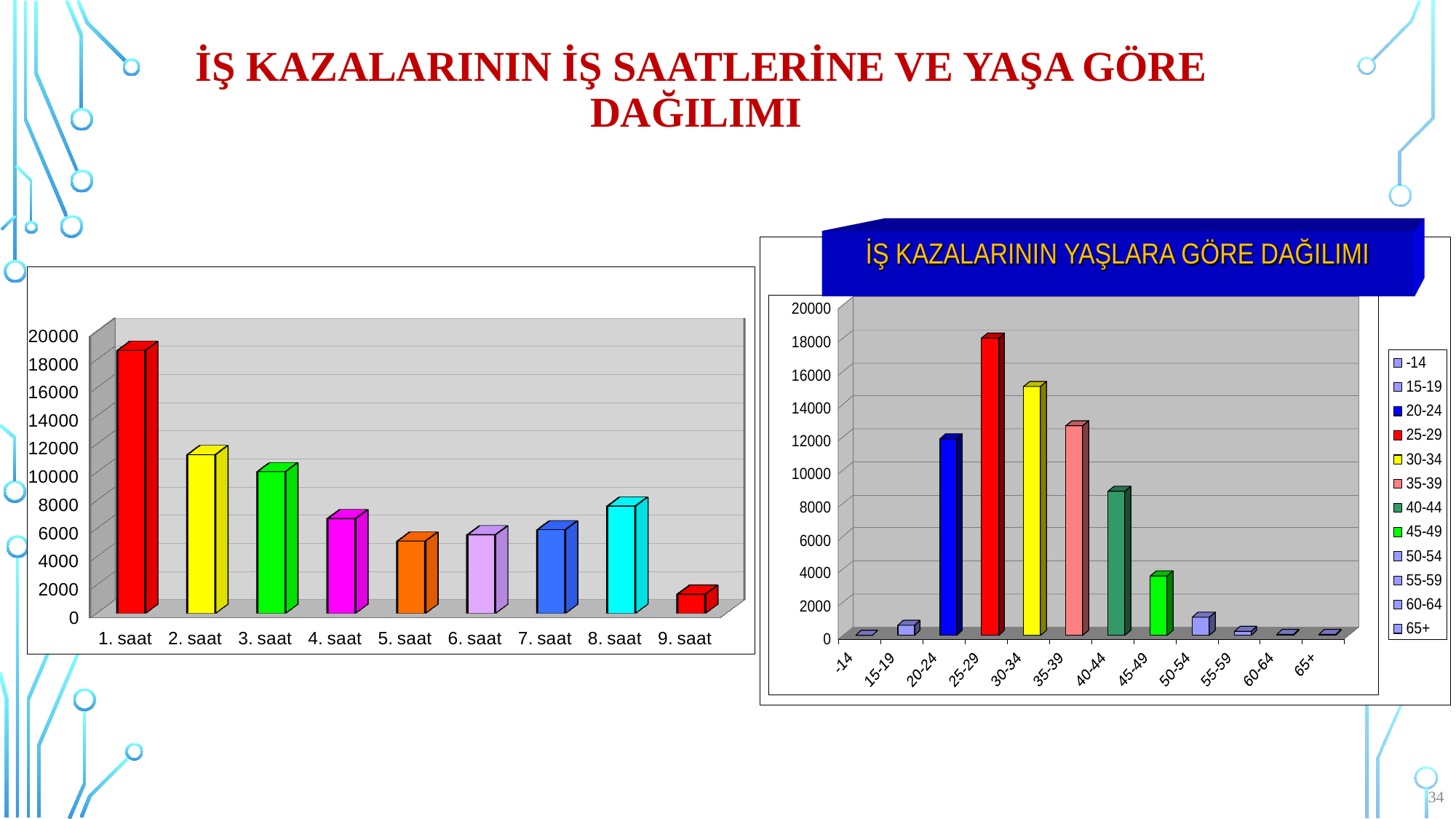
On the left chart, how many hour categories are shown on the x axis? 9 On the chart titled 'İŞ KAZALARININ YAŞLARA GÖRE DAĞILIMI', which age group has the highest number of accidents? 25-29 On the chart titled 'İŞ KAZALARININ YAŞLARA GÖRE DAĞILIMI', which is larger, the value for 20-24 or the value for 40-44? 20-24 On the left chart, which hour has the lowest number of accidents? 9. saat What kind of chart is the chart titled 'İŞ KAZALARININ YAŞLARA GÖRE DAĞILIMI'? bar chart On the left chart, is the value for 1. saat greater or less than 16000? greater On the chart titled 'İŞ KAZALARININ YAŞLARA GÖRE DAĞILIMI', how many entries does the legend list? 12 On the left chart, is the value for 9. saat greater or less than 2000? less On the chart titled 'İŞ KAZALARININ YAŞLARA GÖRE DAĞILIMI', is the value for 30-34 greater or less than 14000? greater On the left chart, which hour has the highest number of accidents? 1. saat On the left chart, which is larger, the value for 2. saat or the value for 5. saat? 2. saat